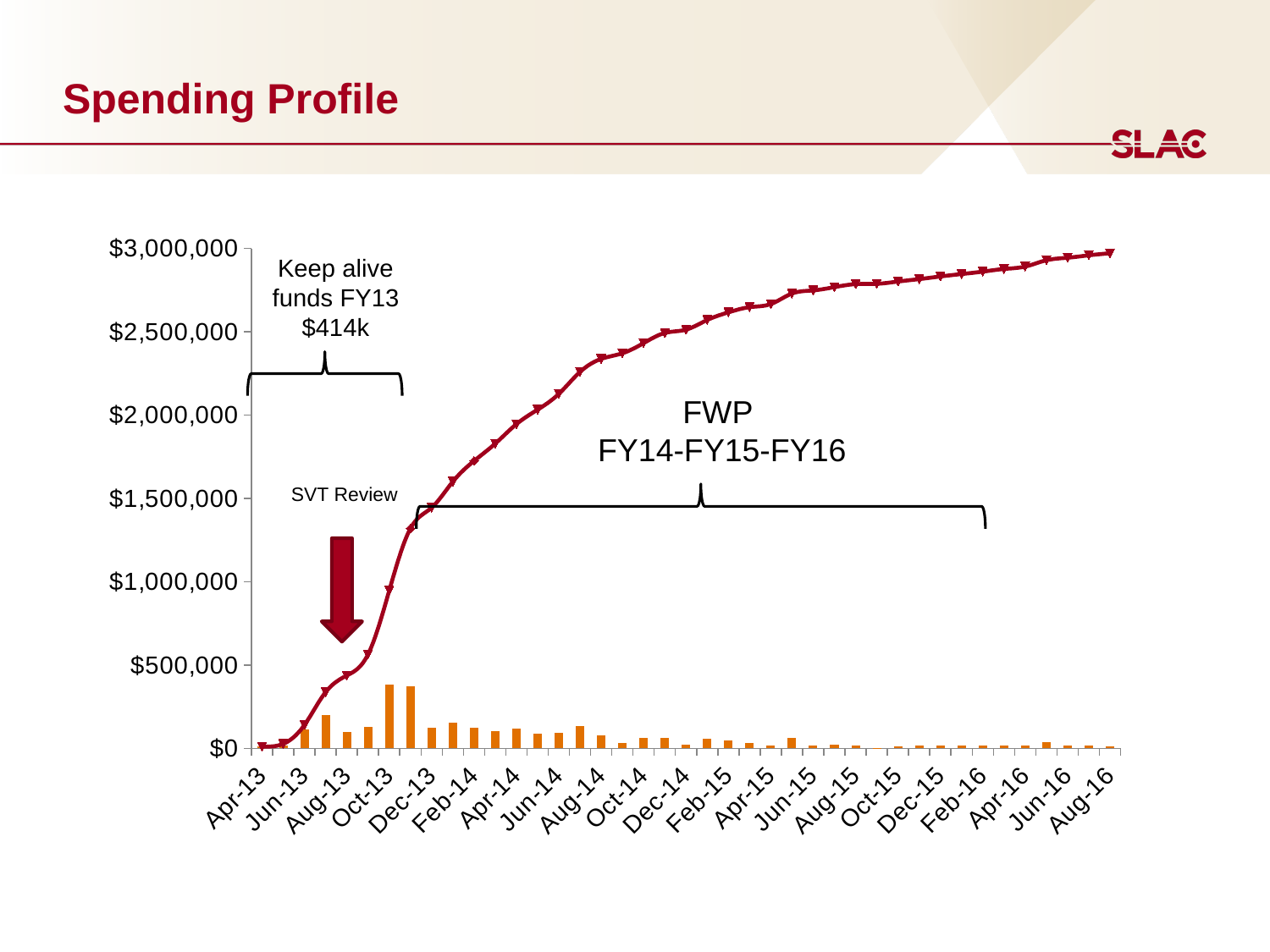
What is the title of the slide containing the chart? Spending Profile According to the annotation on the chart, how much were the keep alive funds in FY13? $414k Which is larger, the red line value at Aug-16 or at Apr-13? Aug-16 Which is larger, the orange bar at Oct-13 or the orange bar at Aug-16? Oct-13 Is the value of the red line at Aug-13 greater or less than $500,000? less Is the value of the red line at Jun-14 greater or less than $2,000,000? greater Is the value of the red line at Aug-16 greater or less than $2,500,000? greater Does the red line rise or fall from Apr-13 to Aug-16? Rises What kind of chart is shown on the slide? A combined bar and line chart How many month labels are shown on the x axis? 21